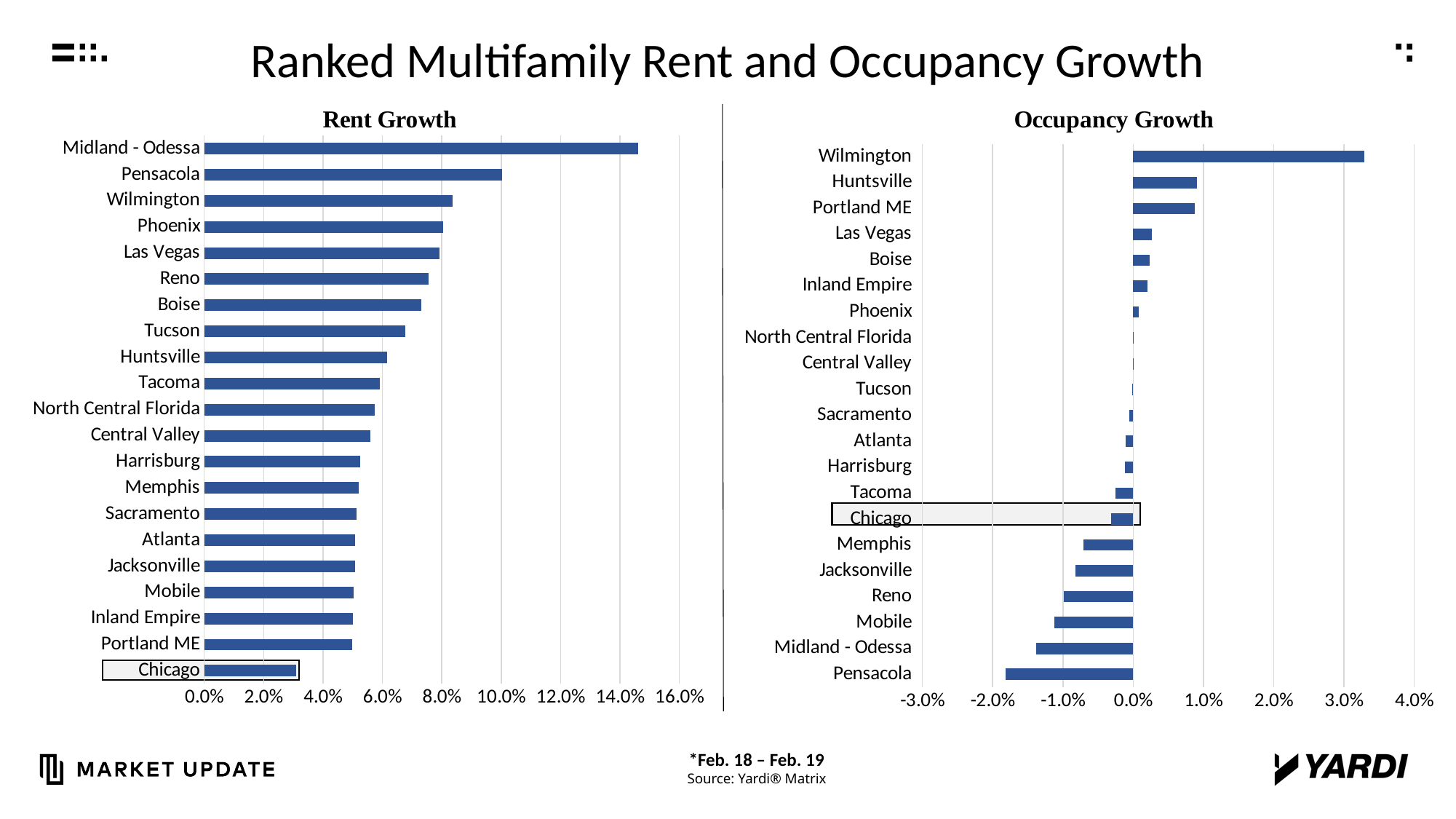
In the Occupancy Growth chart, which market has the lowest occupancy growth? Pensacola In the Rent Growth chart, is the value for Chicago greater or less than 4.0%? less How many markets are shown in the Occupancy Growth chart? 21 What kind of chart is the Rent Growth chart? bar chart In the Rent Growth chart, which market has the highest rent growth? Midland - Odessa In the Rent Growth chart, which has the larger value, Pensacola or Wilmington? Pensacola In the Rent Growth chart, is the value for Midland - Odessa greater or less than 14.0%? greater In the Occupancy Growth chart, which market has the highest occupancy growth? Wilmington In the Rent Growth chart, which market has the lowest rent growth? Chicago In the Occupancy Growth chart, is the value for Pensacola greater or less than -1.0%? less Which market is highlighted with a box in both charts? Chicago